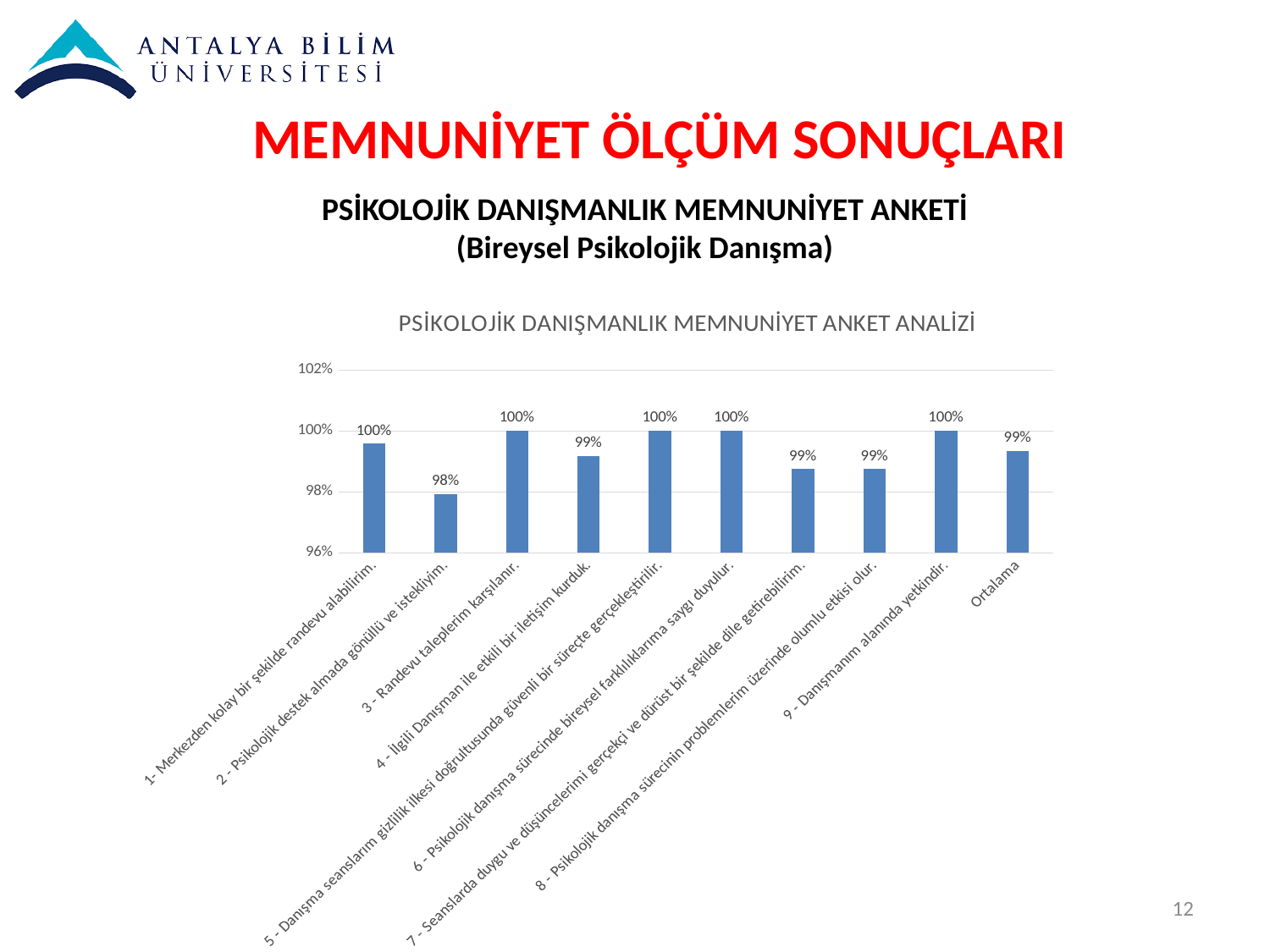
What is the value for "2 - Psikolojik destek almada gönüllü ve istekliyim."? 98% Which is larger: the value for "3 - Randevu taleplerim karşılanır." or the value for "2 - Psikolojik destek almada gönüllü ve istekliyim."? 3 - Randevu taleplerim karşılanır. What is the value for "4 - İlgili Danışman ile etkili bir iletişim kurduk."? 99% What is the value for "9 - Danışmanım alanında yetkindir."? 100% What is the difference between the value for "1- Merkezden kolay bir şekilde randevu alabilirim." and the value for "2 - Psikolojik destek almada gönüllü ve istekliyim."? 2% How many categories have a value of 100%? 5 What is the title of the chart? PSİKOLOJİK DANIŞMANLIK MEMNUNİYET ANKET ANALİZİ Is the value for "2 - Psikolojik destek almada gönüllü ve istekliyim." greater or less than 100%? less Which category has the lowest value? 2 - Psikolojik destek almada gönüllü ve istekliyim. What is the value for "Ortalama"? 99% How many categories are shown on the x axis? 10 What kind of chart is shown on the slide? Bar chart